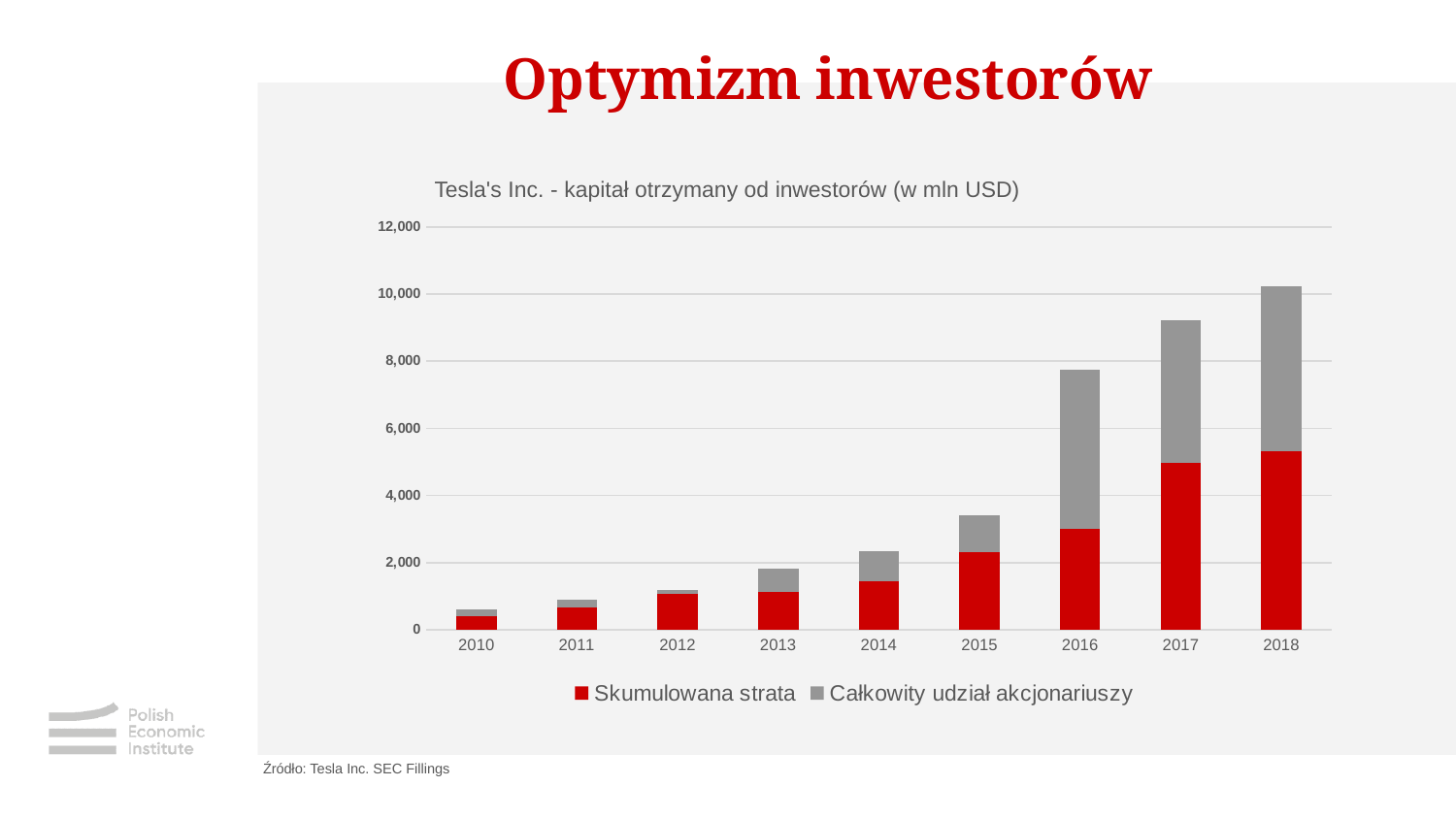
What is the title of the chart? Tesla's Inc. - kapitał otrzymany od inwestorów (w mln USD) What kind of chart is shown on the slide? stacked bar chart How many years are shown on the x axis of the chart? 9 Is the total bar for 2015 greater or less than 4,000? less Which year has the highest total bar in the chart? 2018 How many series does the chart legend list? 2 Do the total bar heights rise or fall from 2010 to 2018? rise Is the total bar for 2018 greater or less than 8,000? greater Which year has the lowest total bar in the chart? 2010 Is the 'Skumulowana strata' segment for 2018 greater or less than 4,000? greater Which year has the larger total bar, 2016 or 2017? 2017